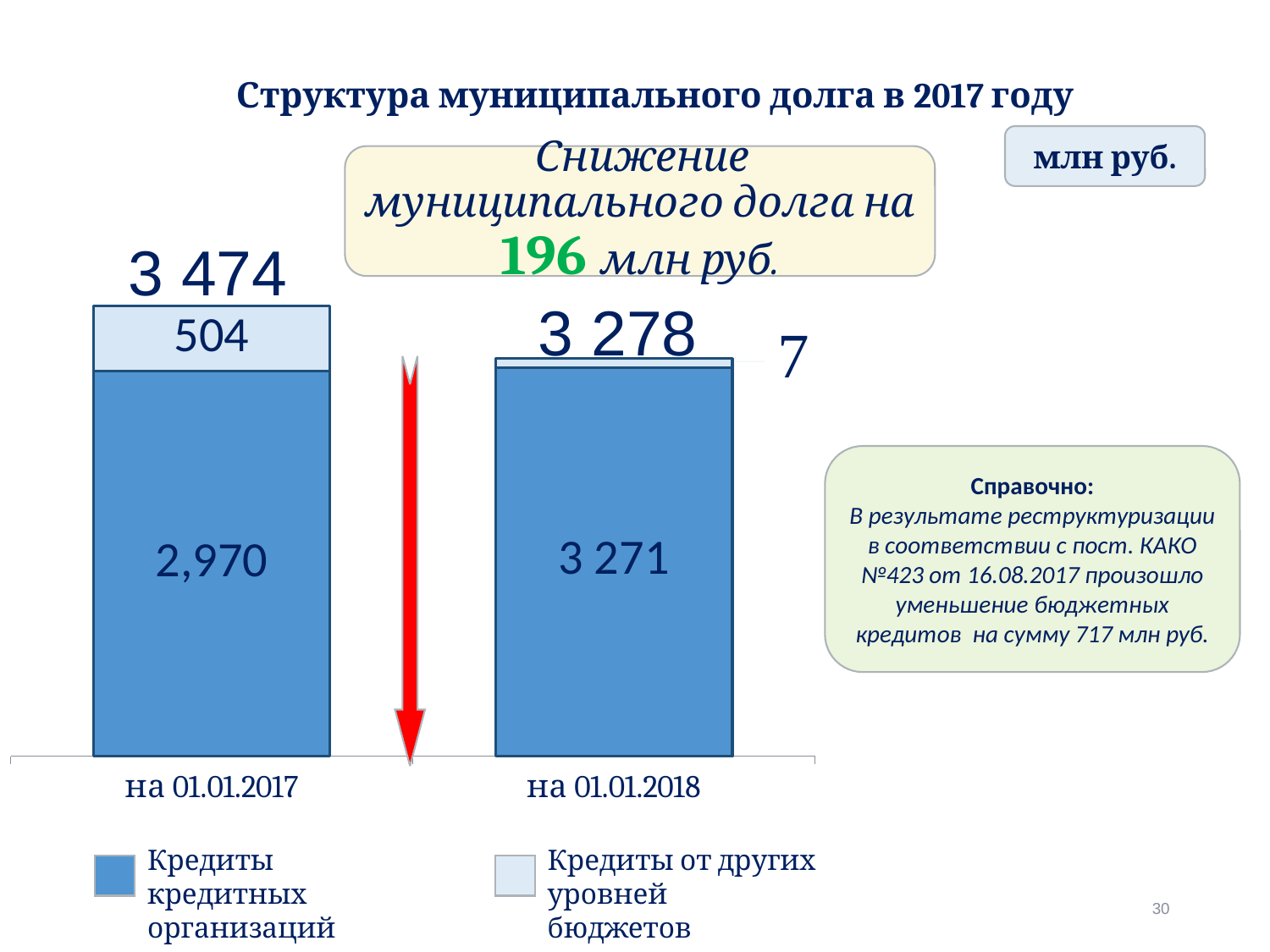
What is the title of the slide's chart? Структура муниципального долга в 2017 году How many series does the legend list? 2 What is the value for Кредиты от других уровней бюджетов on 01.01.2018? 7 Which date has the larger value for Кредиты кредитных организаций, 01.01.2017 or 01.01.2018? 01.01.2018 What is the total of the stacked bar for 01.01.2018? 3 278 What is the value for Кредиты от других уровней бюджетов on 01.01.2017? 504 What is the total of the stacked bar for 01.01.2017? 3 474 What is the difference between Кредиты от других уровней бюджетов on 01.01.2017 and on 01.01.2018? 497 By how much did the total municipal debt decrease from 01.01.2017 to 01.01.2018? 196 What is the value for Кредиты кредитных организаций on 01.01.2018? 3 271 What kind of chart is shown on the slide? Stacked bar chart What is the value for Кредиты кредитных организаций on 01.01.2017? 2,970